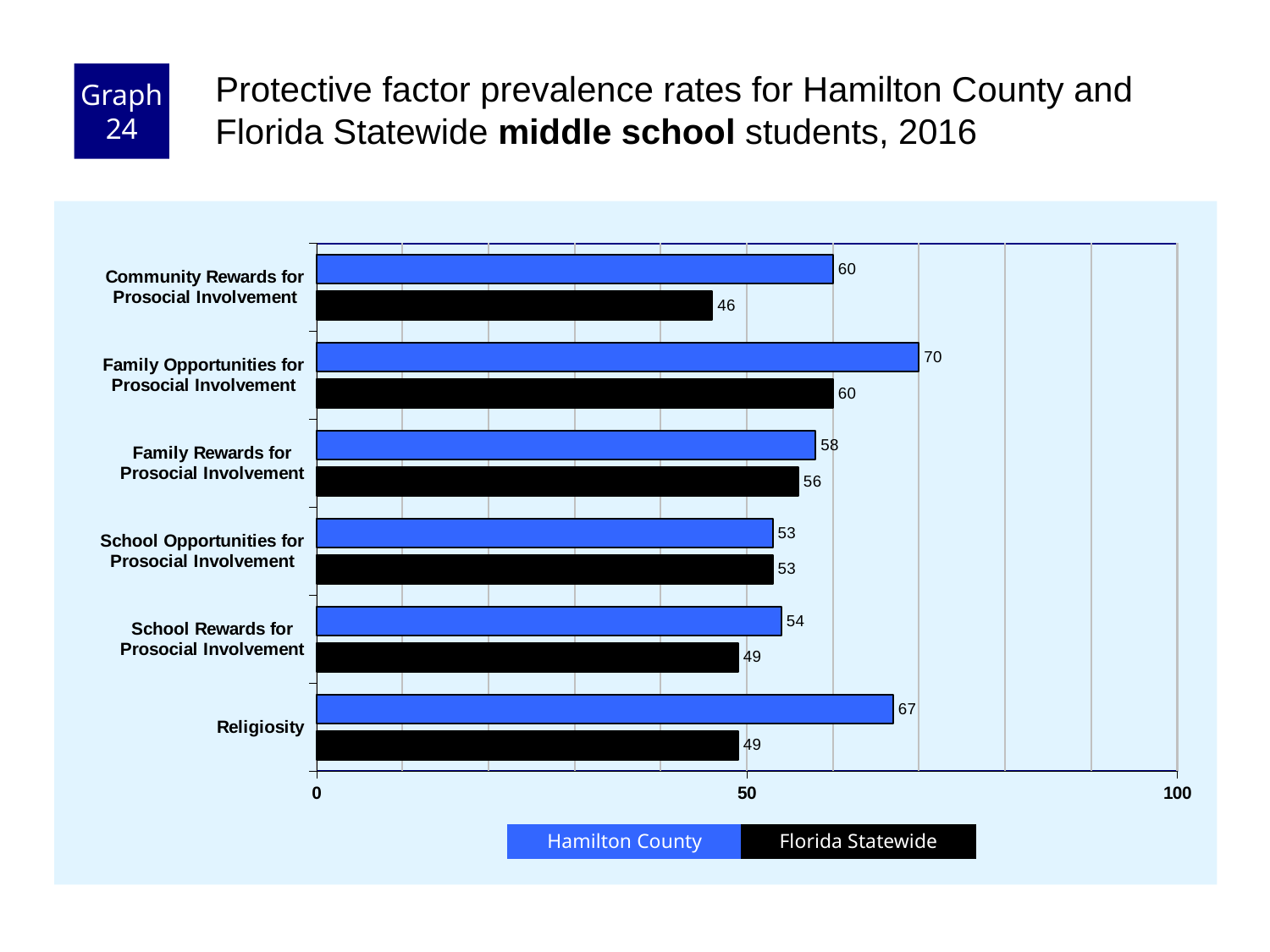
What is the Hamilton County value for Family Opportunities for Prosocial Involvement? 70 What is the Florida Statewide value for Community Rewards for Prosocial Involvement? 46 What is the difference between the Hamilton County and Florida Statewide values for Religiosity? 18 Which category has the highest Hamilton County value? Family Opportunities for Prosocial Involvement Which is larger for Community Rewards for Prosocial Involvement: the Hamilton County value or the Florida Statewide value? Hamilton County How many categories are shown on the chart? 6 Which category has the lowest Florida Statewide value? Community Rewards for Prosocial Involvement How many series does the legend list? 2 What is the Florida Statewide value for Religiosity? 49 Which colour represents Florida Statewide in the chart? Black Is the Hamilton County value for Religiosity greater or less than 50? greater What kind of chart is shown on the slide? Bar chart